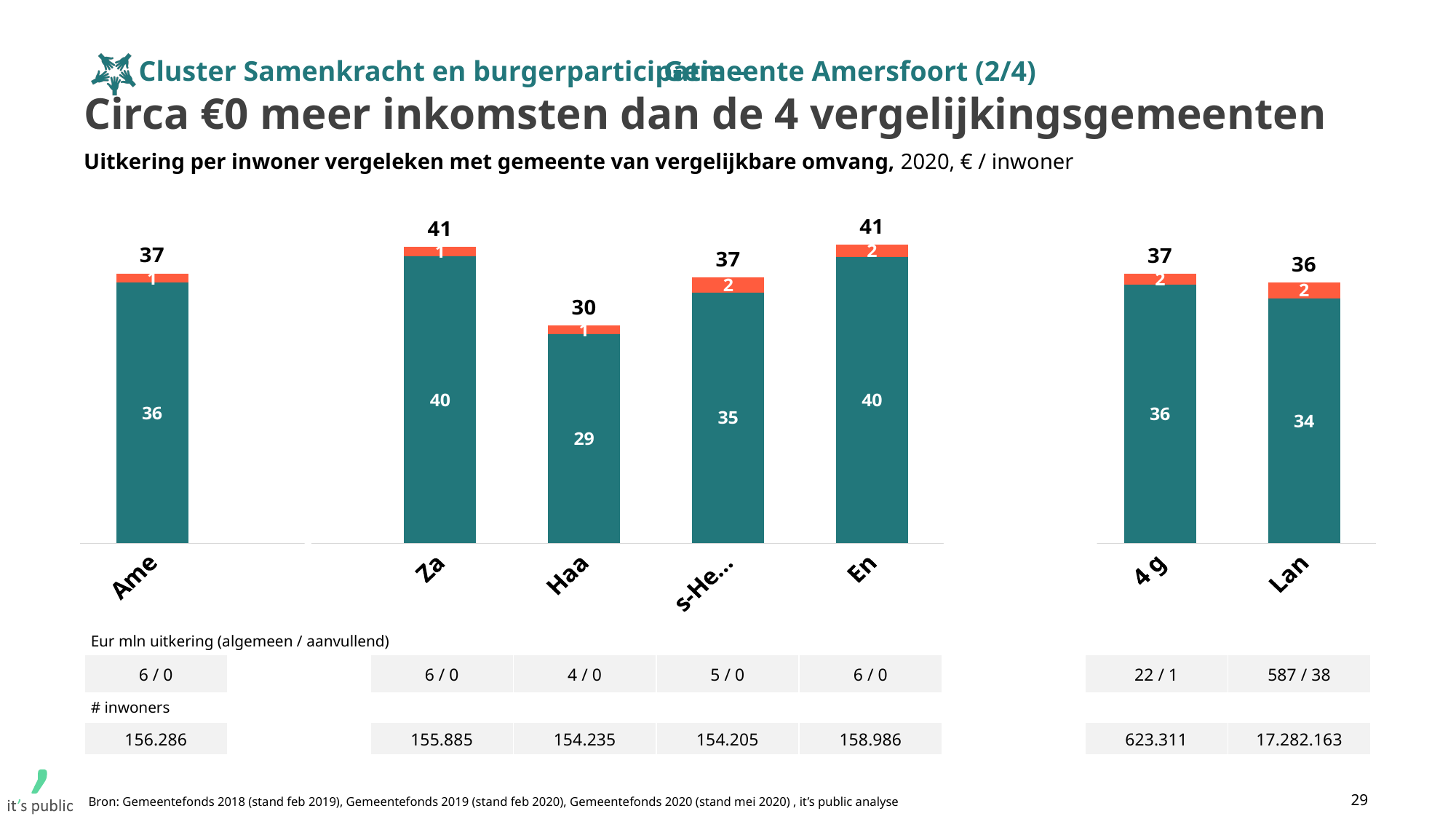
What is the total value shown above the bar for Ame? 37 What is the value of the teal (lower) segment of the bar for Haa? 29 Which has a larger total, Za or Lan? Za What is the total value shown above the bar for Haa? 30 What unit is stated in the chart subtitle for the values plotted? € / inwoner How many bars are plotted in the chart? 7 Which category has the lowest total value? Haa What is the value of the teal (lower) segment of the bar for Za? 40 What is the total of the stacked bar for 4 g, given its segments of 36 and 2? 37 What kind of chart is shown on the slide? Stacked bar chart What is the difference between the total for En and the total for Haa? 11 What is the value of the orange (upper) segment of the bar for Lan? 2